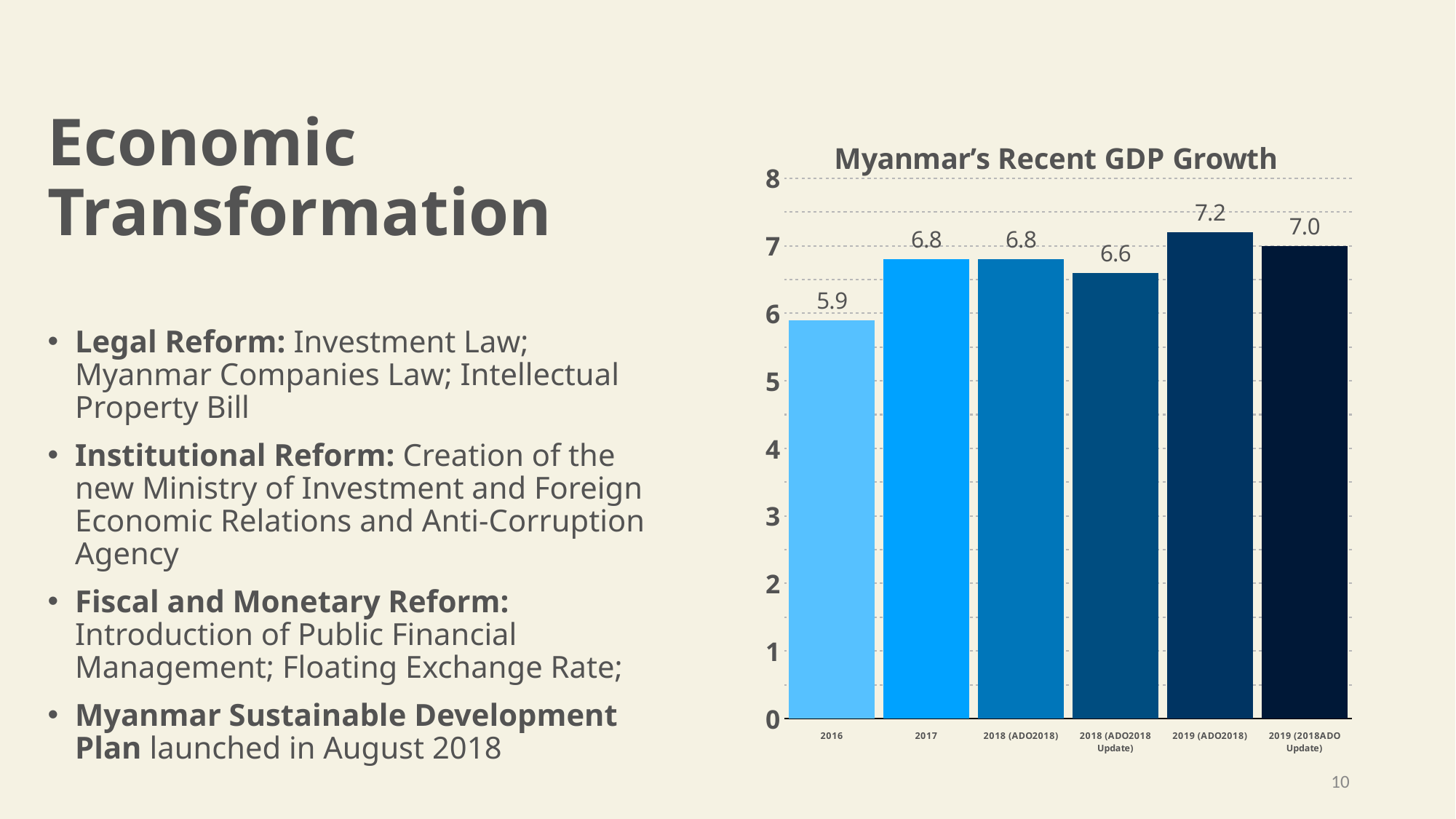
What is the GDP growth value for 2019 (ADO2018)? 7.2 What kind of chart is shown on the slide? Bar chart How many bars are shown in the chart? 6 What is the GDP growth value for 2016? 5.9 What is the difference between the 2019 (ADO2018) value and the 2016 value? 1.3 Is the value for 2017 greater or less than 6? greater What is the title of the chart? Myanmar's Recent GDP Growth What is the GDP growth value for 2018 (ADO2018 Update)? 6.6 Which category has the lowest GDP growth value? 2016 Which is larger, the value for 2019 (ADO2018) or the value for 2019 (2018ADO Update)? 2019 (ADO2018) Which category has the highest GDP growth value? 2019 (ADO2018) What is the difference between the 2017 value and the 2018 (ADO2018 Update) value? 0.2